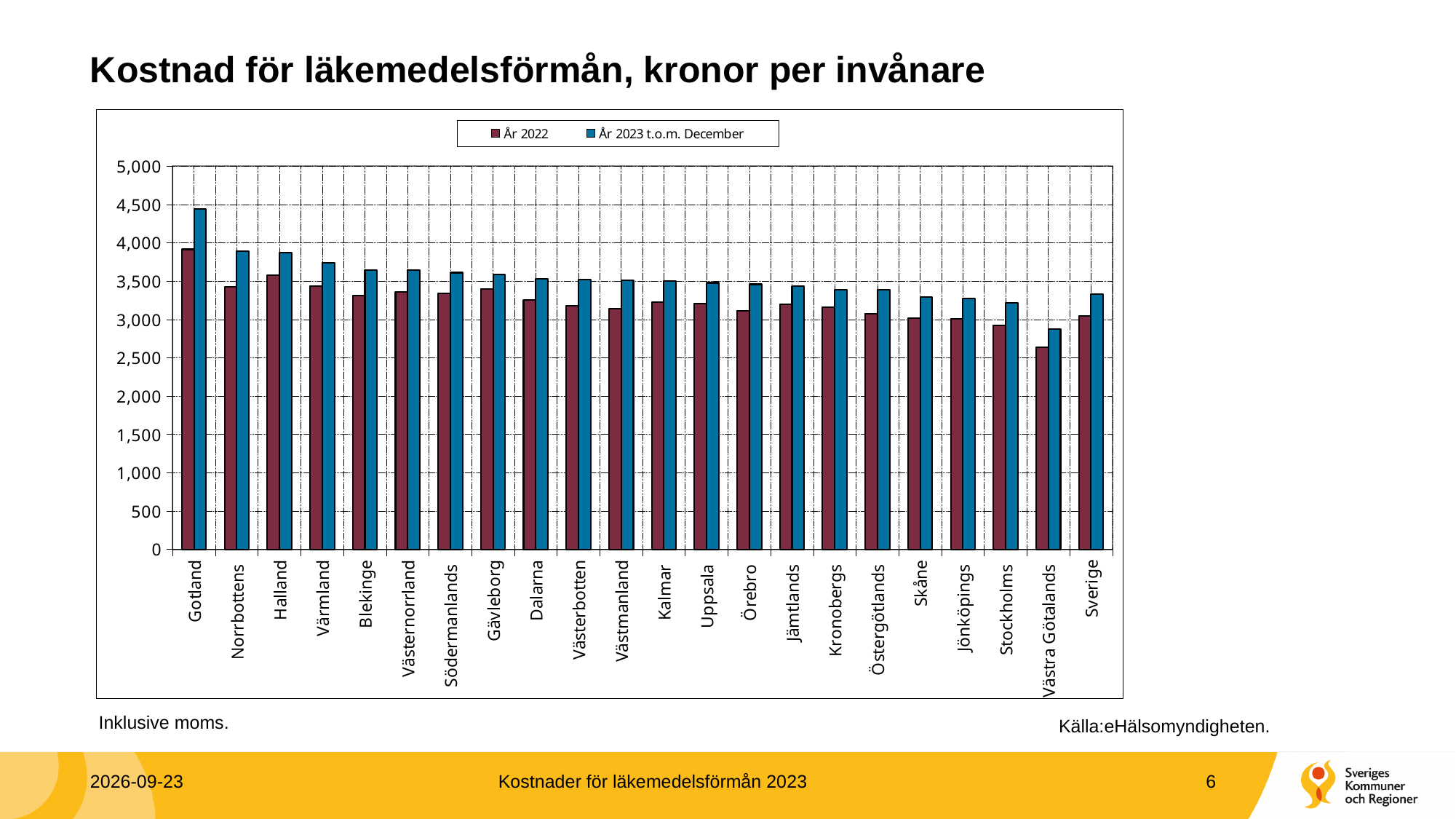
How many categories are shown on the x axis? 22 What is the second legend entry? År 2023 t.o.m. December Is the value for Gotland in År 2023 t.o.m. December greater or less than 4,000? greater What kind of chart is shown on the slide? bar chart Is the value for Västra Götalands in År 2022 greater or less than 3,000? less Which category has the lowest value for År 2022? Västra Götalands Which has the larger År 2022 value: Stockholms or Västra Götalands? Stockholms Which is larger for Gotland: the År 2022 value or the År 2023 t.o.m. December value? År 2023 t.o.m. December Which category has the lowest value for År 2023 t.o.m. December? Västra Götalands How many series does the legend list? 2 Which category has the highest value for År 2023 t.o.m. December? Gotland Is the value for Norrbottens in År 2023 t.o.m. December greater or less than 3,500? greater